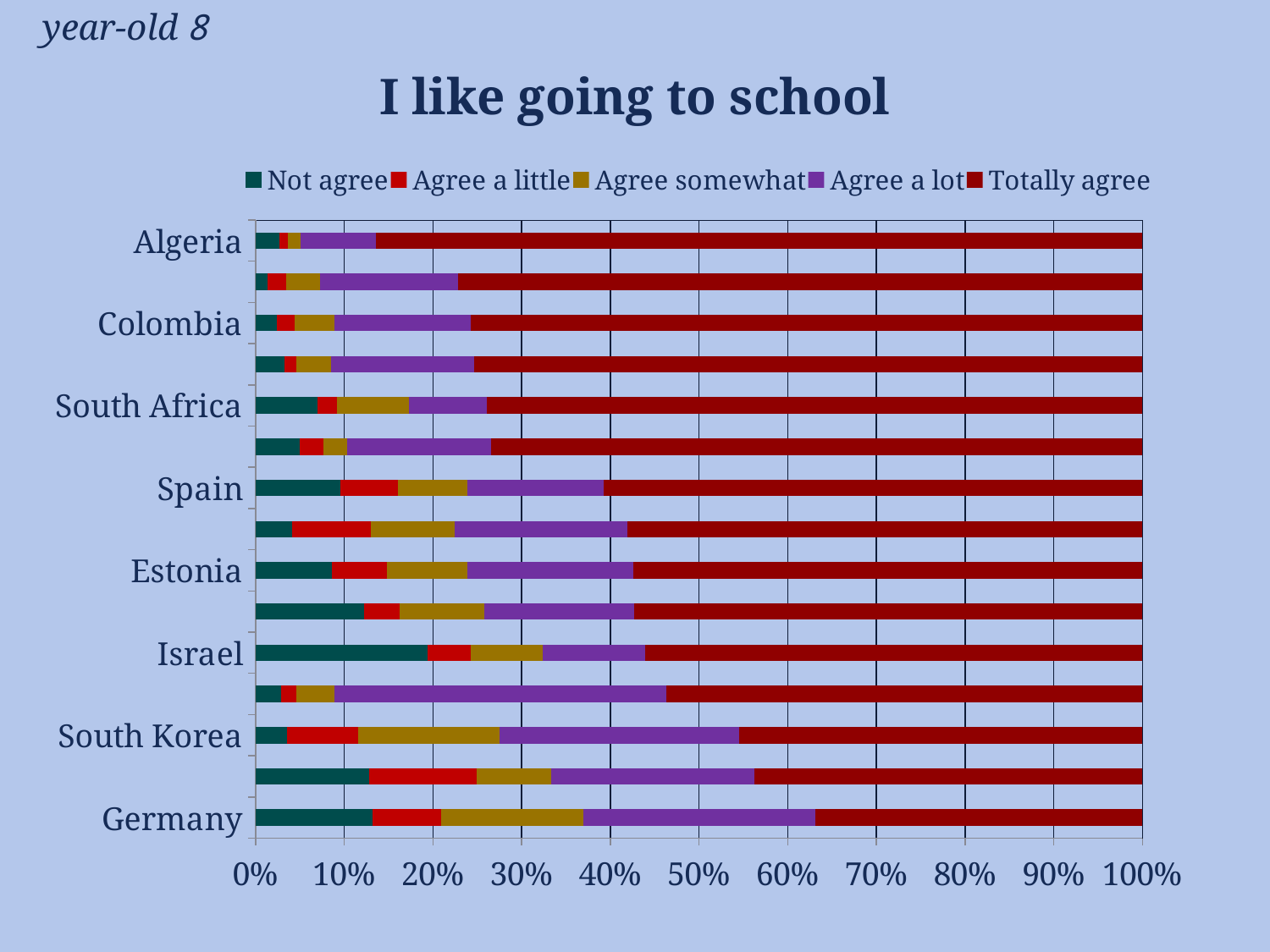
Is the 'Not agree' value for Germany greater or less than 10%? greater Which legend entry is shown in dark red? Totally agree Is the 'Totally agree' value for Algeria greater or less than 80%? greater Which labeled country has the smallest 'Totally agree' share? Germany What is the title of the chart? I like going to school Which has the larger 'Not agree' share, Israel or Germany? Israel How many series does the legend list? 5 What kind of chart is shown on the slide? Stacked bar chart Is the 'Totally agree' value for Germany greater or less than 40%? less Moving down the chart from Algeria to Germany, does the 'Totally agree' share generally rise or fall? fall Which labeled country has the largest 'Totally agree' share? Algeria